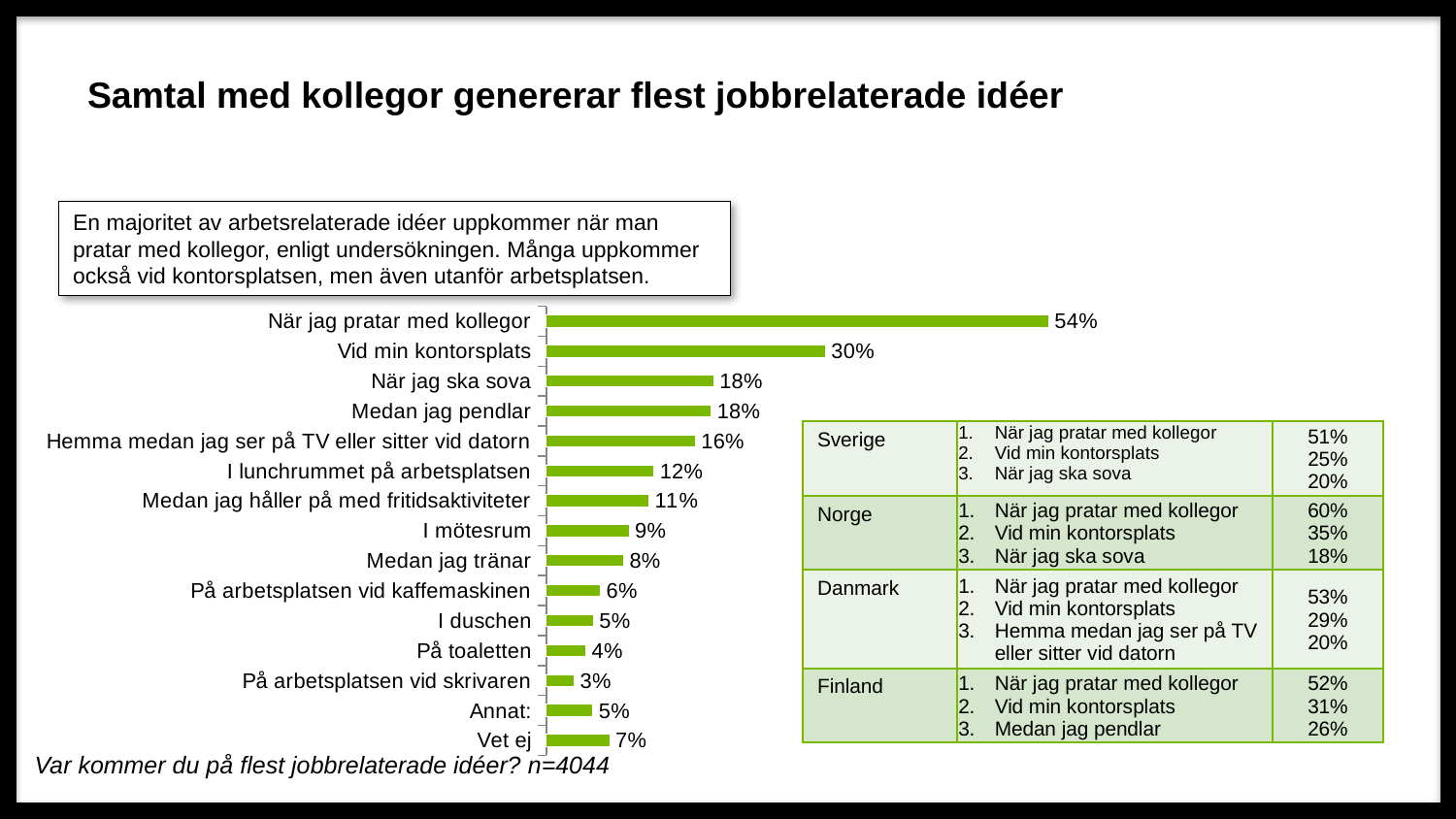
What is the value for "Vet ej"? 7% What kind of chart is shown on the slide? Bar chart What percentage is shown for "När jag pratar med kollegor"? 54% Which is larger, "I lunchrummet på arbetsplatsen" or "Medan jag tränar"? I lunchrummet på arbetsplatsen What colour are the bars in the chart? Green How many categories are plotted in the chart? 15 What is the value for "Vid min kontorsplats"? 30% What is the difference between "När jag pratar med kollegor" and "Vid min kontorsplats"? 24 percentage points Which category has the highest value in the chart? När jag pratar med kollegor Which category has the lowest value in the chart? På arbetsplatsen vid skrivaren What percentage is shown for "I mötesrum"? 9% What is the difference between "Hemma medan jag ser på TV eller sitter vid datorn" and "På toaletten"? 12 percentage points